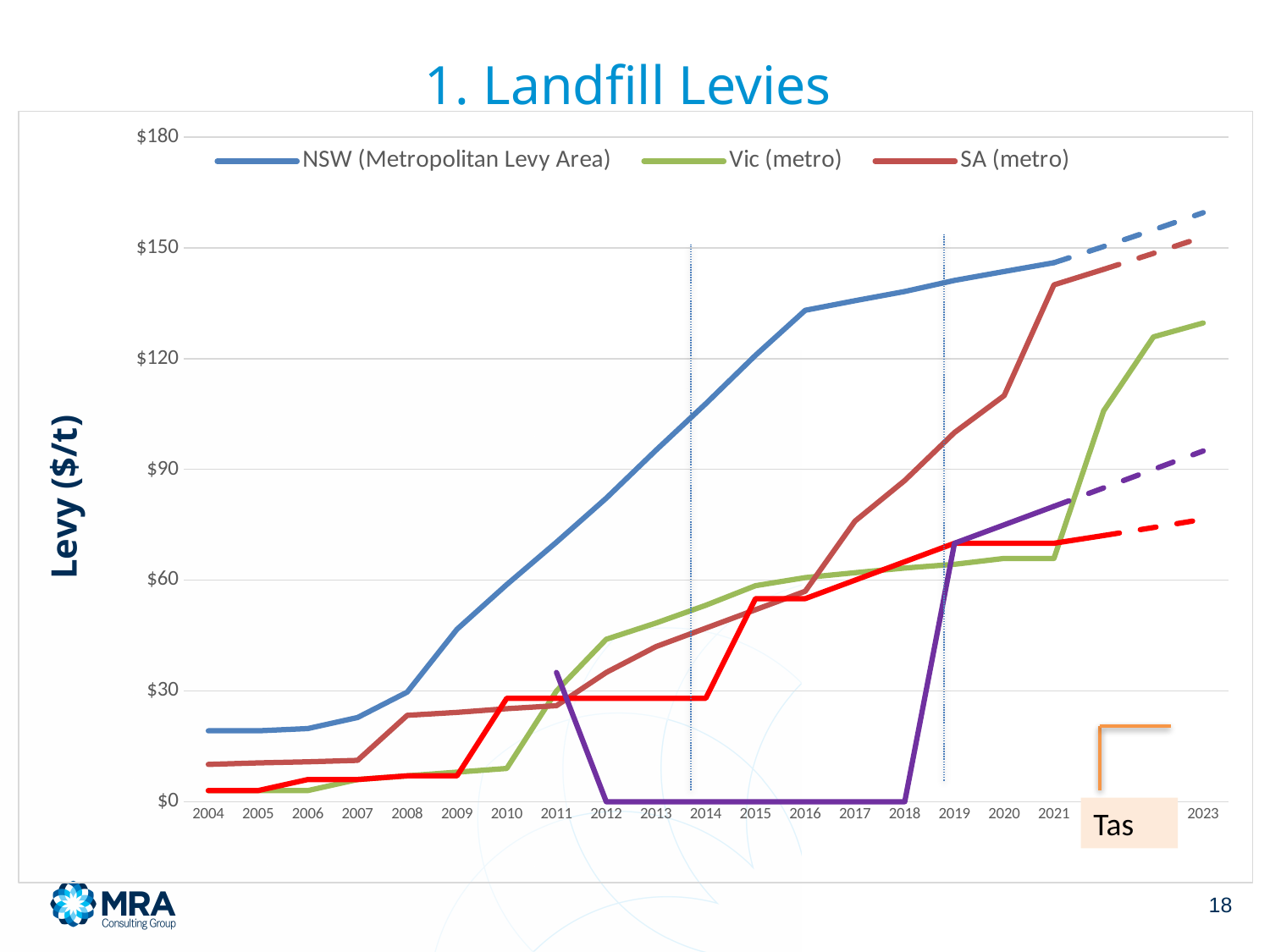
Which of the legend series has the highest levy in 2021? NSW (Metropolitan Levy Area) Does the NSW (Metropolitan Levy Area) levy generally rise or fall from 2004 to 2021? Rise In 2016, which is larger: the NSW (Metropolitan Levy Area) levy or the Vic (metro) levy? NSW (Metropolitan Levy Area) Is the value for SA (metro) in 2021 greater or less than $120? greater How many series does the chart legend list? 3 Is the value for Vic (metro) in 2021 greater or less than $90? less What kind of chart is shown on the slide? Line chart Is the value for NSW (Metropolitan Levy Area) in 2016 greater or less than $120? greater Which series does the blue line in the legend represent? NSW (Metropolitan Levy Area) What is the label of the vertical axis? Levy ($/t)